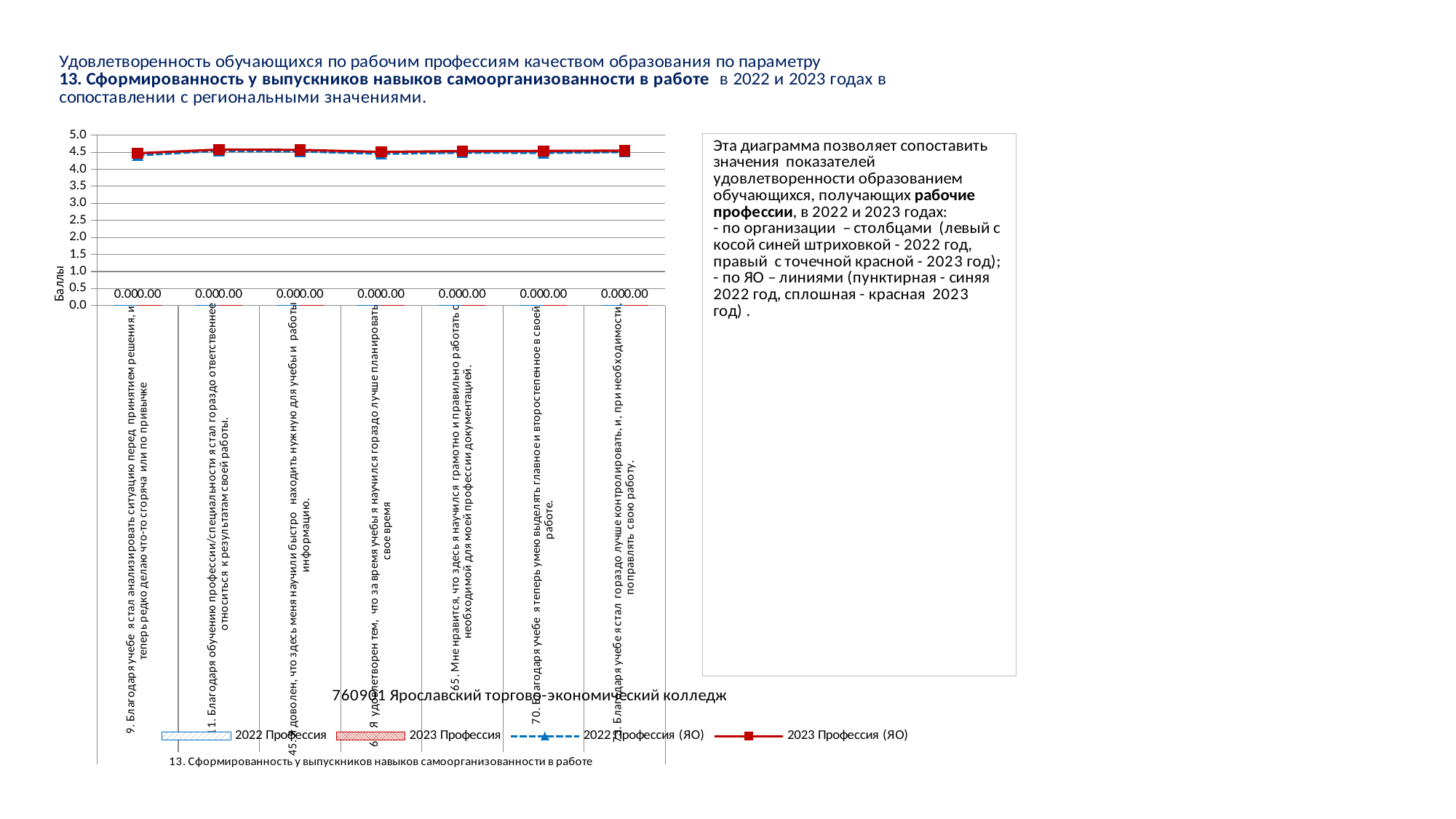
Which series in the legend is drawn as a solid red line with square markers? 2023 Профессия (ЯО) Is the value of the 2023 Профессия (ЯО) line for the first category (9. Благодаря учебе я стал анализировать ситуацию...) greater or less than 4.0? greater How many categories are shown along the x axis of the chart? 7 How many series does the chart legend list? 4 Is the value of the 2022 Профессия (ЯО) line for the category 45. Я доволен, что здесь меня научили быстро находить нужную для учебы и работы информацию greater or less than 4.0? greater What is the label of the vertical axis of the chart? Баллы Is the value of the 2023 Профессия (ЯО) line for the category 65. Мне нравится, что здесь я научился грамотно и правильно работать... greater or less than 5.0? less What is the highest value shown on the vertical axis of the chart? 5.0